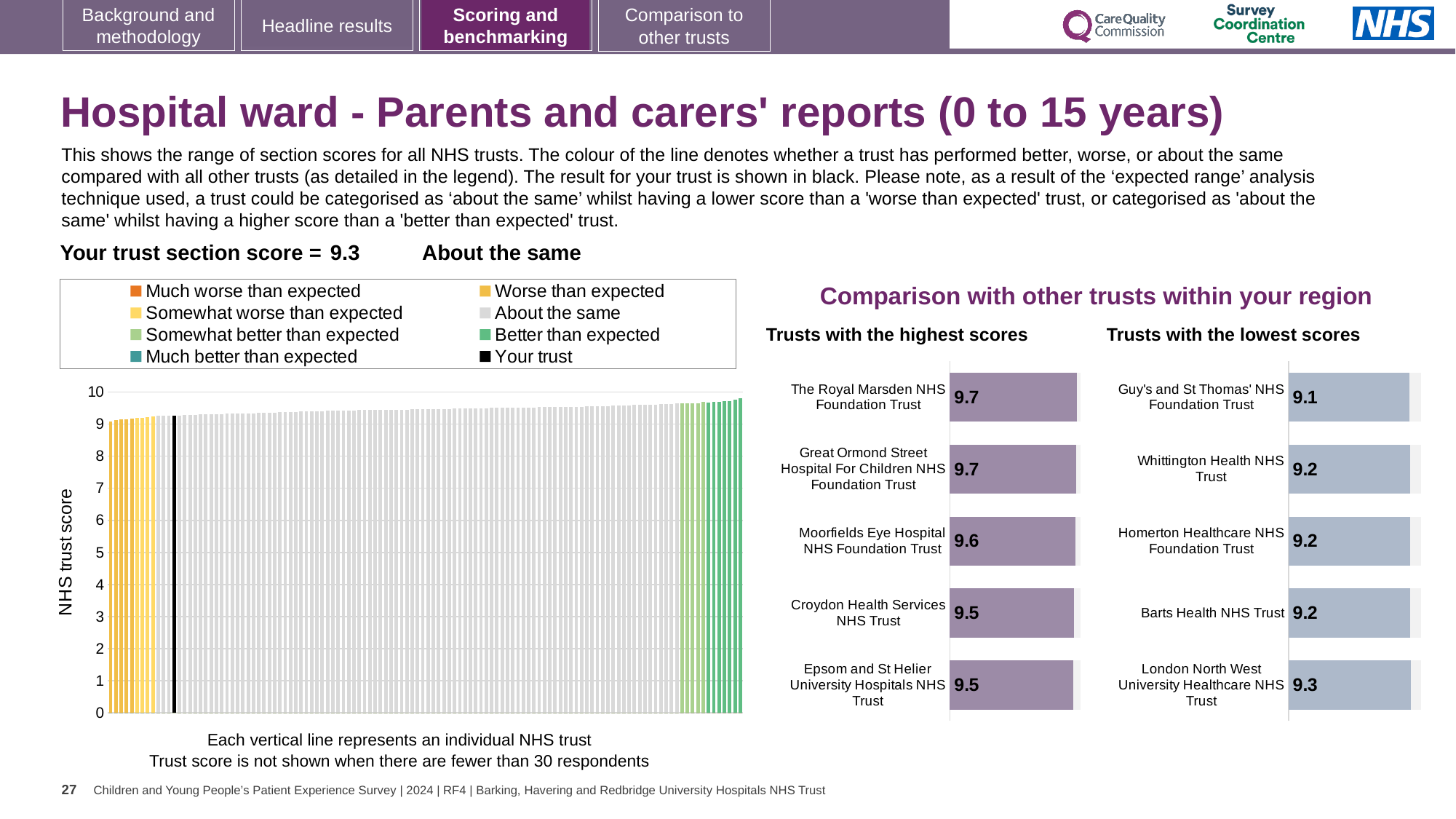
In the 'NHS trust score' chart on the left, is the value for the black 'Your trust' bar greater or less than 5? greater In the 'Trusts with the highest scores' chart, what is the score for Croydon Health Services NHS Trust? 9.5 How many trusts are listed in the 'Trusts with the lowest scores' chart? 5 In the 'Trusts with the lowest scores' chart, what is the score for Guy's and St Thomas' NHS Foundation Trust? 9.1 In the 'Trusts with the highest scores' chart, which has the larger score: The Royal Marsden NHS Foundation Trust or Moorfields Eye Hospital NHS Foundation Trust? The Royal Marsden NHS Foundation Trust In the 'Trusts with the highest scores' chart, what is the difference between the score for The Royal Marsden NHS Foundation Trust and the score for Croydon Health Services NHS Trust? 0.2 What kind of chart is the 'NHS trust score' chart on the left of the slide? Bar chart How many entries does the legend above the 'NHS trust score' chart list? 8 In the 'Trusts with the lowest scores' chart, which trust has the highest score? London North West University Healthcare NHS Trust In the 'Trusts with the lowest scores' chart, what is the difference between the score for London North West University Healthcare NHS Trust and the score for Guy's and St Thomas' NHS Foundation Trust? 0.2 In the 'Trusts with the lowest scores' chart, which trust has the lowest score? Guy's and St Thomas' NHS Foundation Trust In the 'Trusts with the highest scores' chart, what is the score for Moorfields Eye Hospital NHS Foundation Trust? 9.6